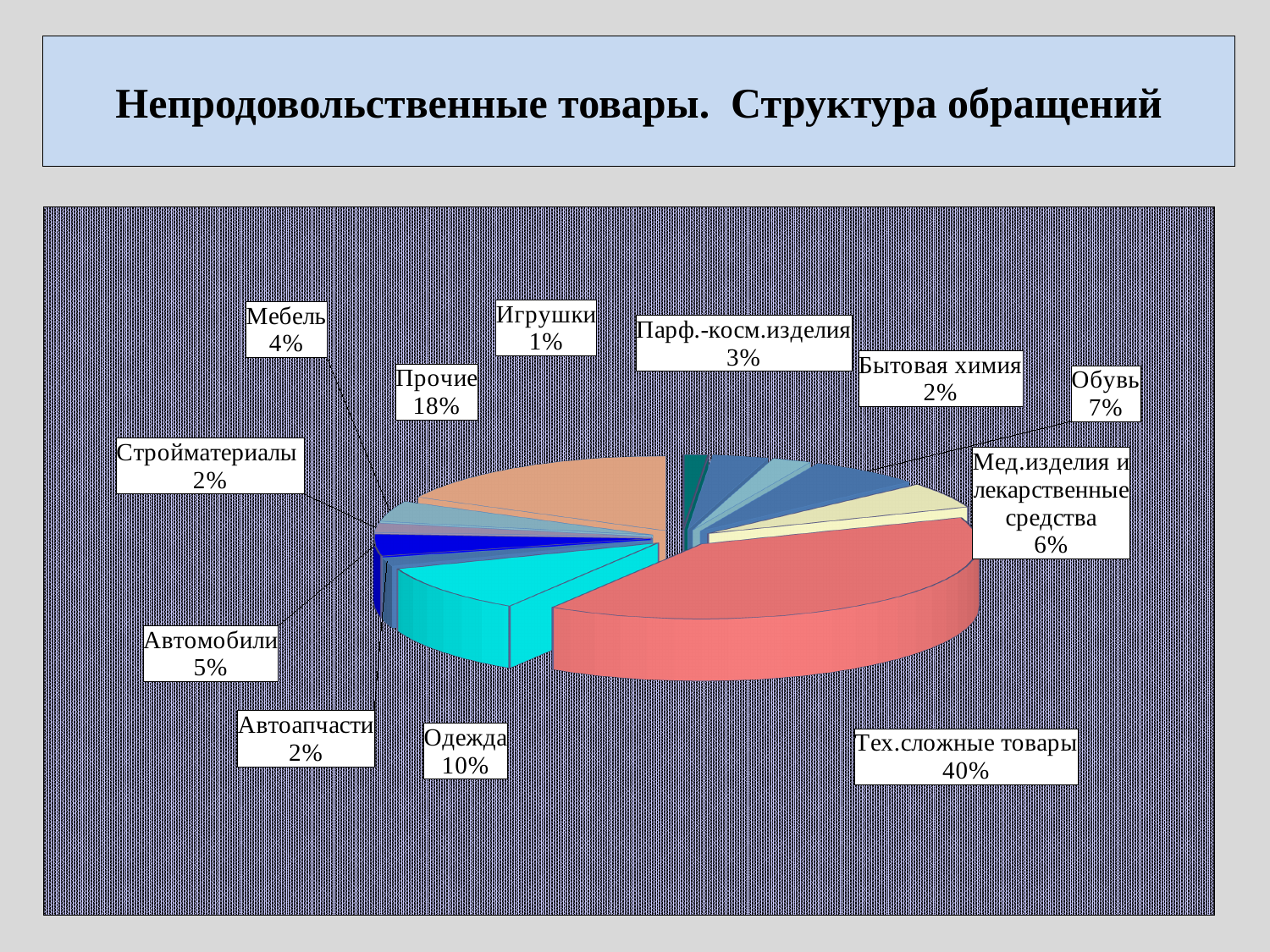
What share of the pie is labelled for Мед.изделия и лекарственные средства? 6% Which category has the largest share of the pie? Тех.сложные товары Which has a larger share, Обувь or Автомобили? Обувь What share of the pie is labelled for Прочие? 18% What is the difference in percentage points between Тех.сложные товары and Прочие? 22 What kind of chart is shown on the slide? pie chart What is the title of the slide? Непродовольственные товары. Структура обращений What is the difference in percentage points between Одежда and Мебель? 6 What share of the pie is labelled for Одежда? 10% How many categories are shown in the pie chart? 12 What share of the pie is labelled for Тех.сложные товары? 40% Which category has the smallest share of the pie? Игрушки